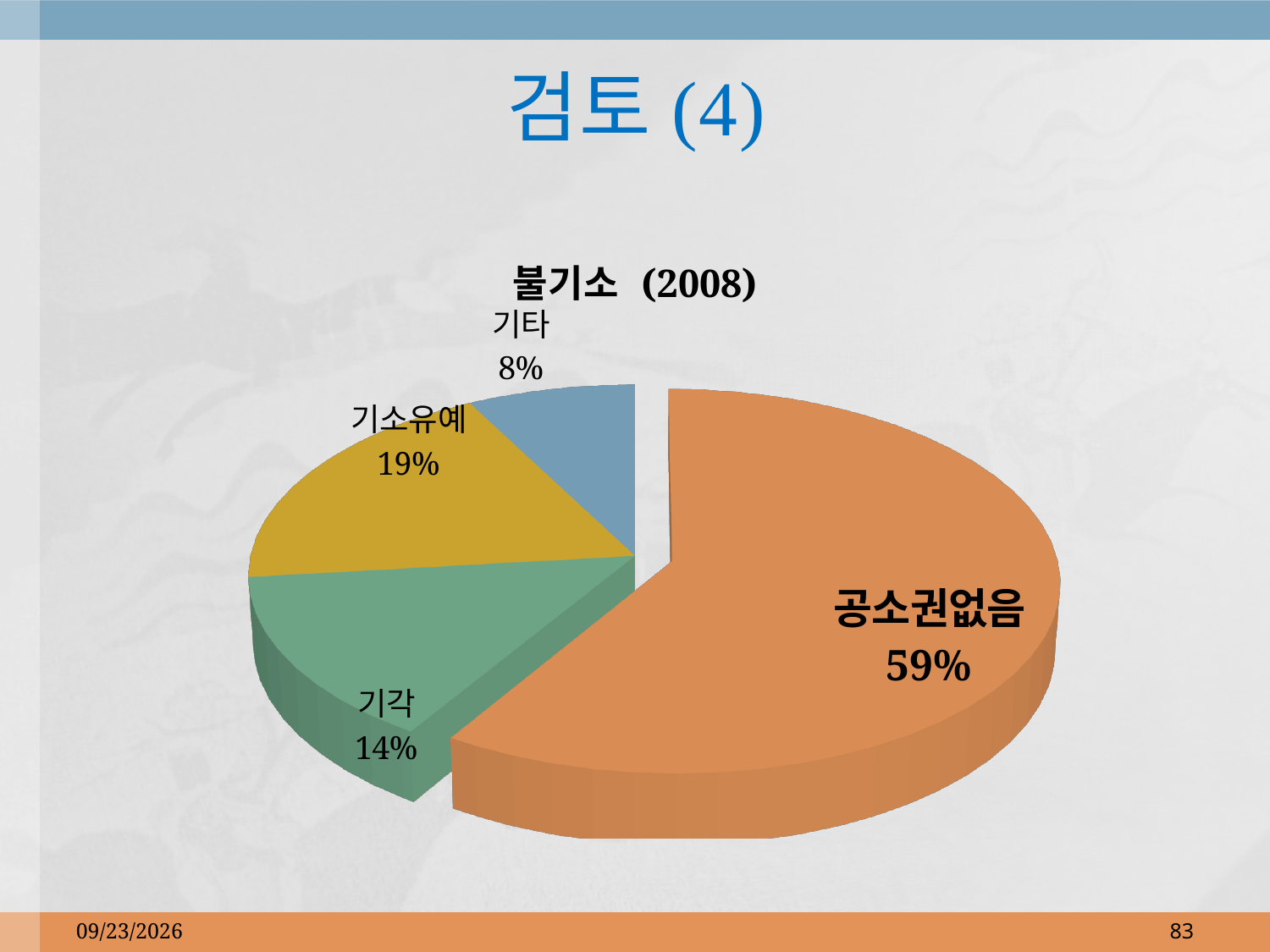
How many categories are shown in the pie chart? 4 What is the difference in percentage points between 공소권없음 and 기소유예? 40 What kind of chart is shown on the slide? pie chart Which category has the largest slice of the pie? 공소권없음 What share of the pie does 기소유예 represent? 19% What is the title of the chart? 불기소 (2008) What is the difference in percentage points between 기소유예 and 기각? 5 What share of the pie does 기각 represent? 14% Which is larger, the share for 기각 or the share for 기타? 기각 What share of the pie does 기타 represent? 8% Which category has the smallest slice of the pie? 기타